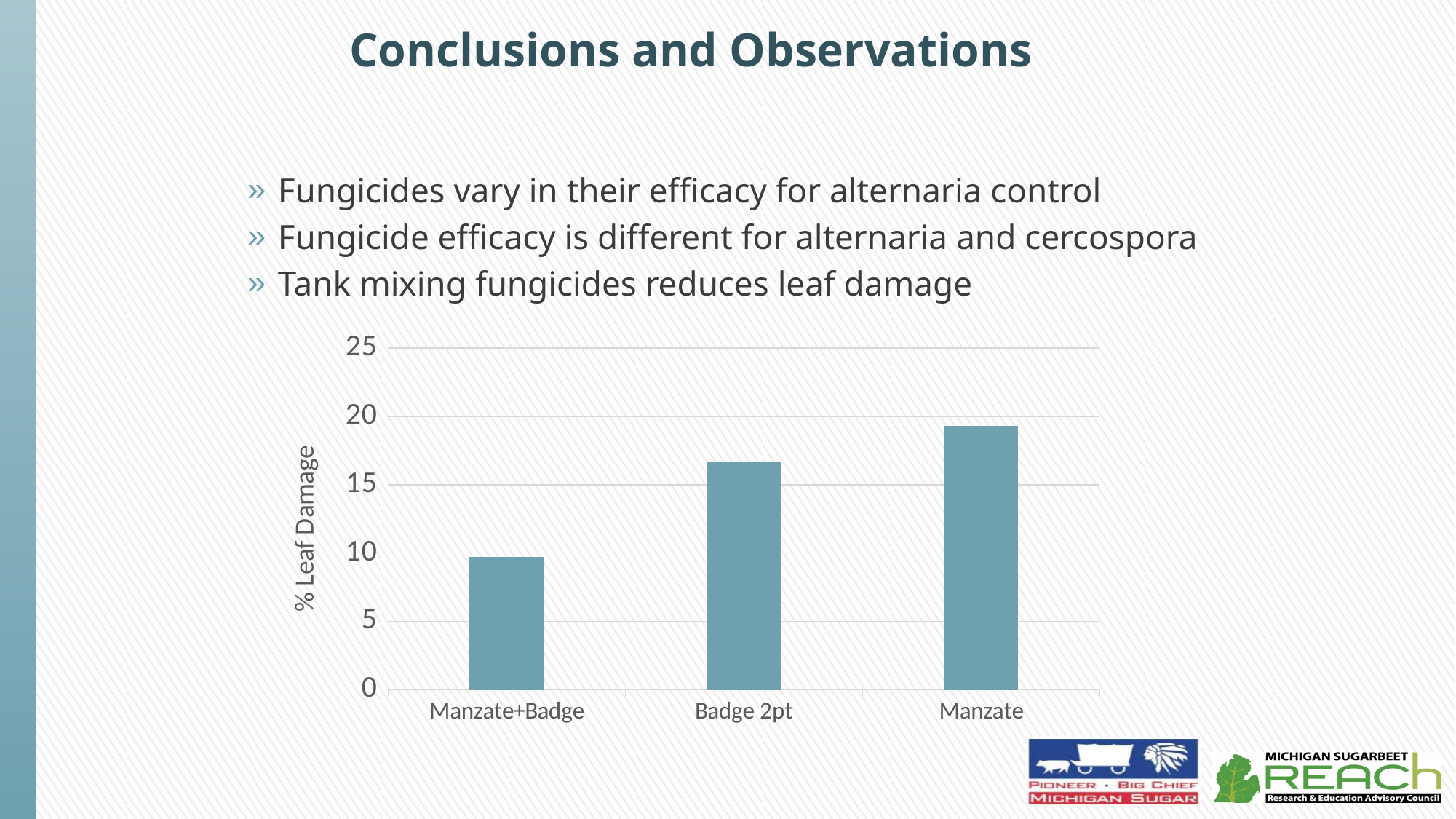
Is the value for Badge 2pt greater or less than 15? greater What is the label on the vertical axis of the chart? % Leaf Damage How many categories are plotted on the x axis of the chart? 3 Which has a lower % Leaf Damage, Manzate or Badge 2pt? Badge 2pt Which category has the highest % Leaf Damage? Manzate Which category has the lowest % Leaf Damage? Manzate+Badge What kind of chart is shown on the slide? bar chart Which has a higher % Leaf Damage, Badge 2pt or Manzate+Badge? Badge 2pt Do the bar values rise or fall from left to right across the x axis? rise Is the value for Manzate greater or less than 15? greater Is the value for Manzate greater or less than 20? less